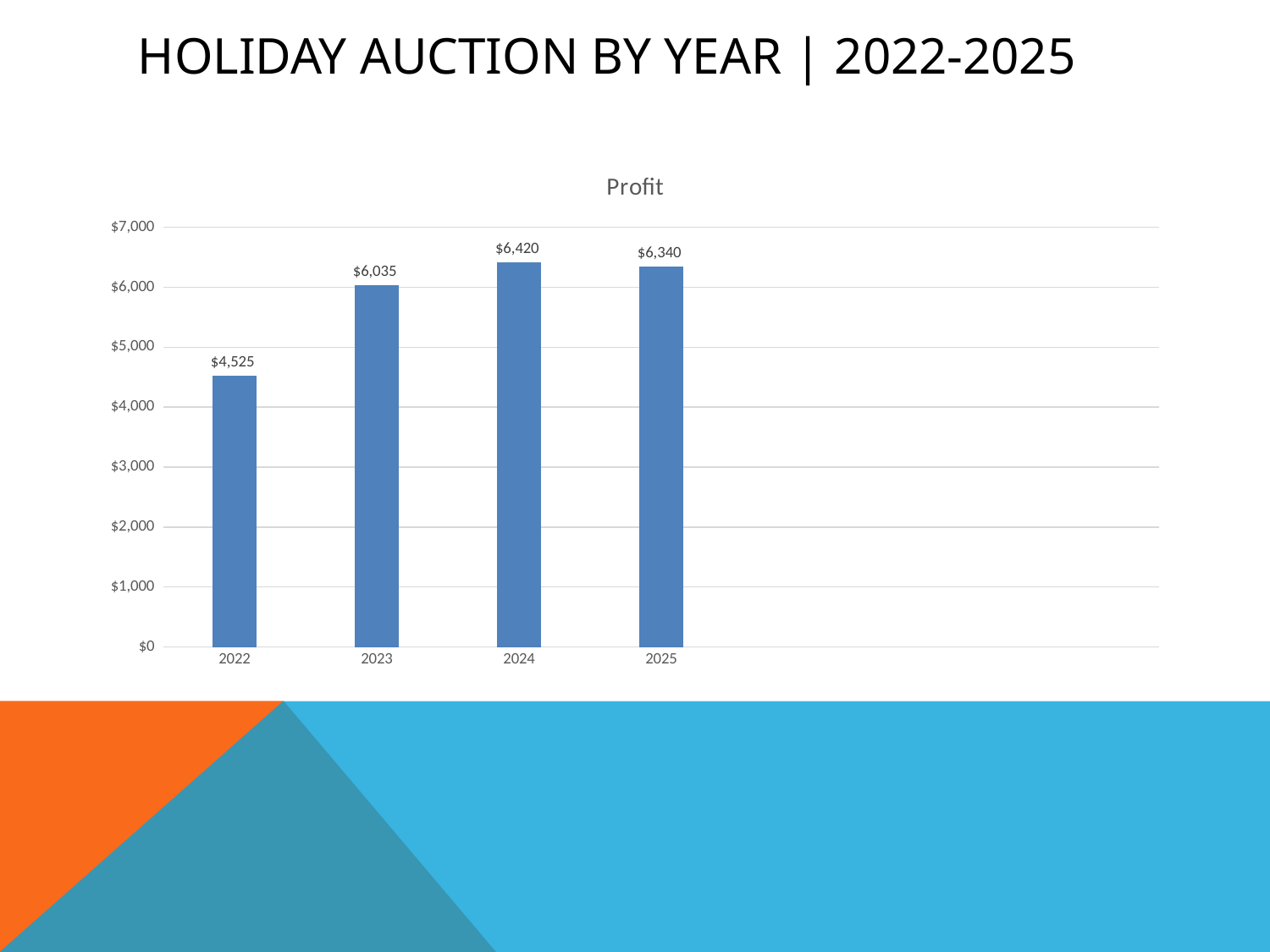
Which year has the larger profit, 2023 or 2025? 2025 What is the difference in profit between 2024 and 2025? $80 What is the profit for 2022? $4,525 What is the difference in profit between 2023 and 2022? $1,510 What is the title of the chart? Profit Which year has the highest profit? 2024 How many years are shown in the chart? 4 Is the profit for 2022 greater or less than $5,000? less What is the profit for 2024? $6,420 What is the profit for 2025? $6,340 What kind of chart is shown on the slide? bar chart Which year has the lowest profit? 2022